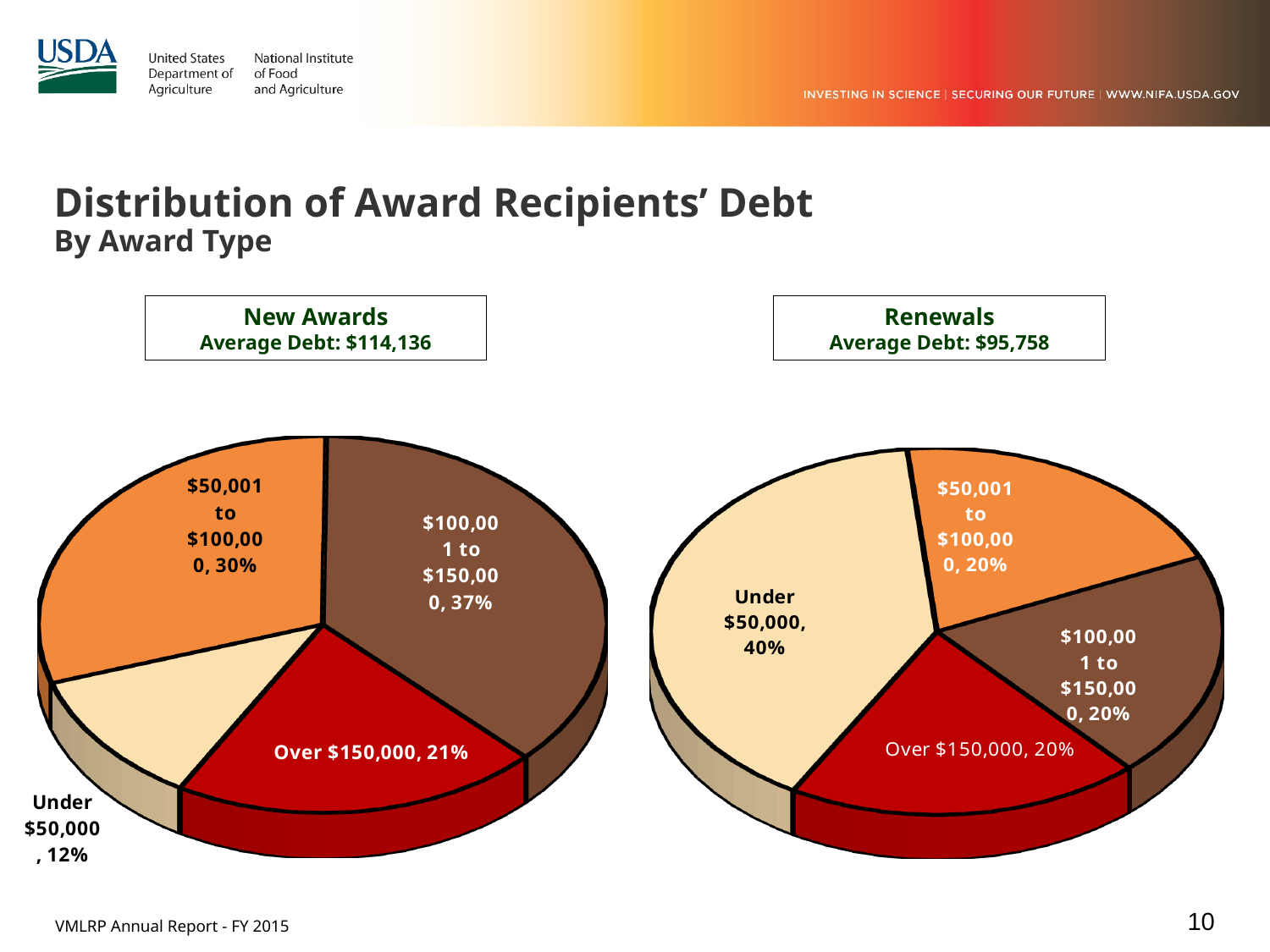
What type of chart is used for the New Awards data? Pie chart How many slices does the Renewals pie chart have? 4 In the New Awards pie chart, which debt category has the smallest share? Under $50,000 In the New Awards pie chart, which debt category has the largest share? $100,001 to $150,000 What is the average debt shown for Renewals? $95,758 Which is larger in the New Awards pie chart: the share for $50,001 to $100,000 or the share for Over $150,000? $50,001 to $100,000 In the Renewals pie chart, what share of recipients have debt under $50,000? 40% In the New Awards pie chart, what share of recipients have debt under $50,000? 12% In the Renewals pie chart, which debt category has the largest share? Under $50,000 In the New Awards pie chart, what share of recipients have debt of $100,001 to $150,000? 37% In the Renewals pie chart, what share of recipients have debt over $150,000? 20% In the New Awards pie chart, what is the difference in percentage points between the $50,001 to $100,000 slice and the Over $150,000 slice? 9 percentage points